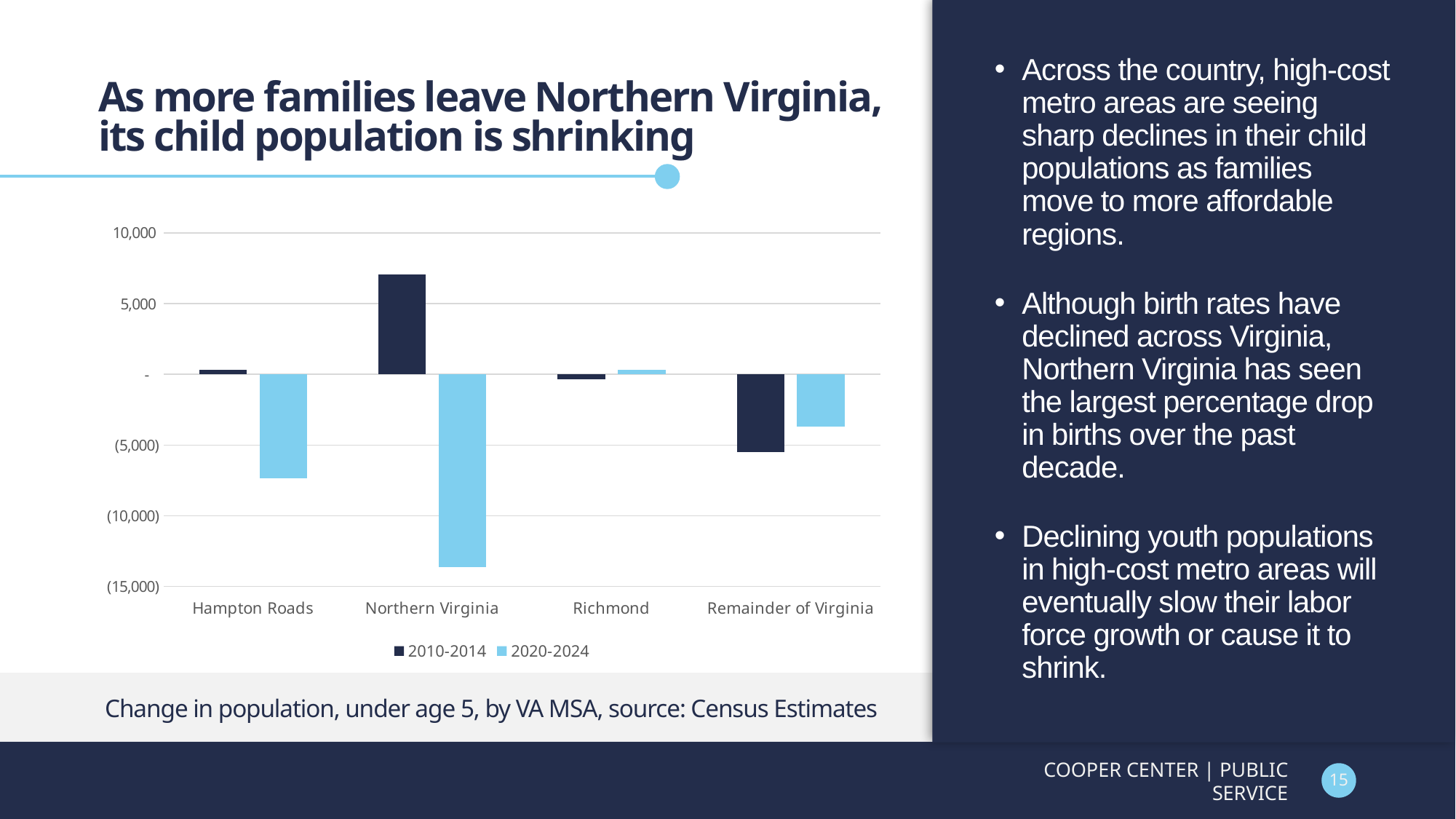
Is the 2020-2024 value for Hampton Roads greater or less than (5,000)? less For Remainder of Virginia, which series has the larger (less negative) value, 2010-2014 or 2020-2024? 2020-2024 Which series is shown in light blue in the chart's legend? 2020-2024 Which region has the lowest 2020-2024 value in the chart? Northern Virginia According to the caption below the chart, what is the source of the data? Census Estimates What kind of chart is shown on the slide? bar chart Is the 2020-2024 value for Remainder of Virginia greater or less than (5,000)? greater How many series does the chart's legend list? 2 Is the 2020-2024 value for Northern Virginia greater or less than (10,000)? less Which region has the highest 2010-2014 value in the chart? Northern Virginia How many categories (regions) are shown on the x axis of the chart? 4